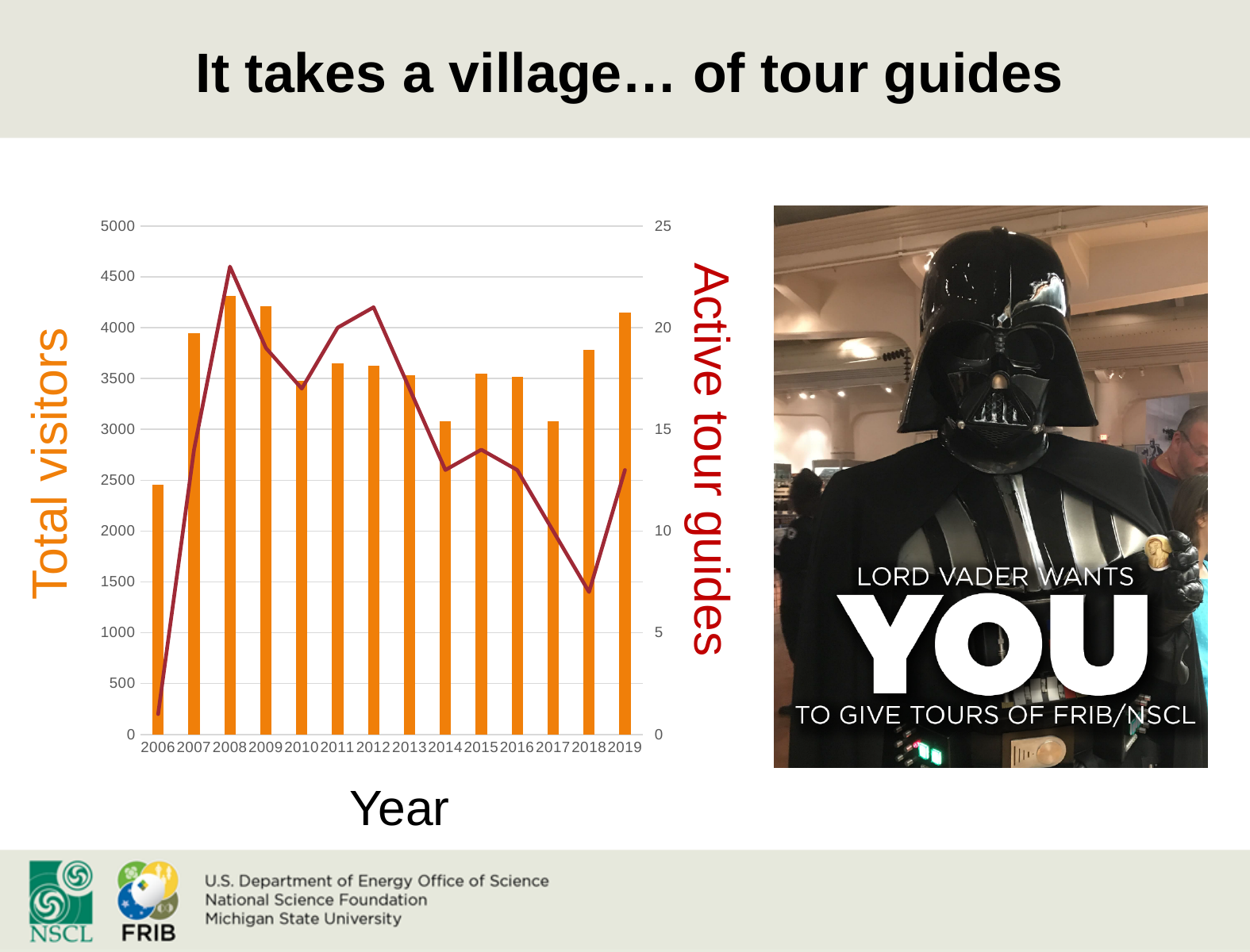
Is the Active tour guides value for 2018 greater or less than 10? less How many years are shown on the x axis of the chart? 14 Is the Total visitors value for 2006 greater or less than 3000? less In which year does the Active tour guides line reach its highest point? 2008 Is the Total visitors value for 2008 greater or less than 4000? greater Does the Active tour guides line rise or fall from 2012 to 2018? fall In which year is the Active tour guides line at its lowest? 2006 Which year has more Total visitors, 2017 or 2019? 2019 What is the label on the right-hand vertical axis of the chart? Active tour guides What kind of chart is shown on the slide? A combined bar and line chart Which year has the highest bar for Total visitors? 2008 Which year has the lowest bar for Total visitors? 2006